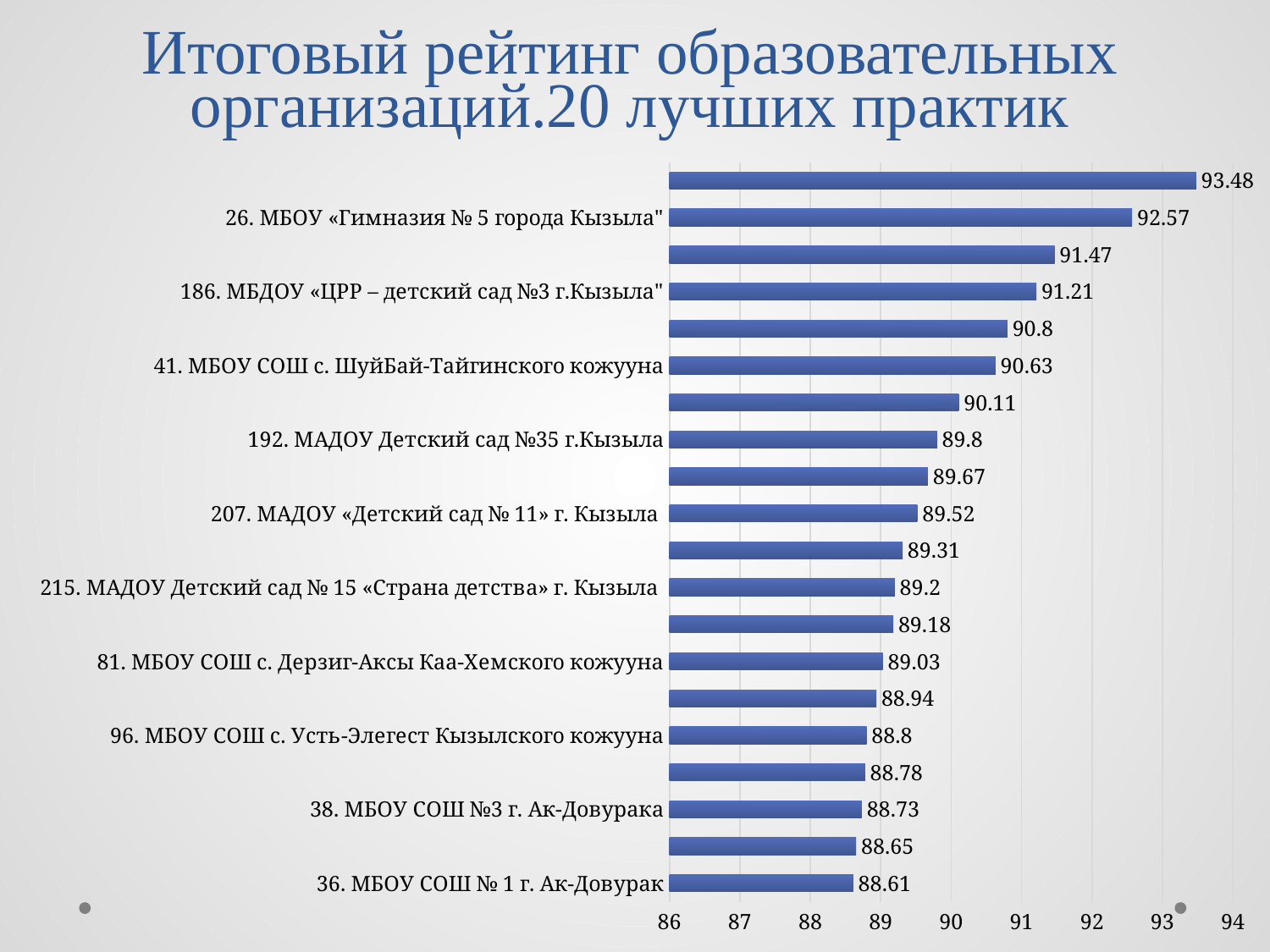
What is the value for 41. МБОУ СОШ с. ШуйБай-Тайгинского кожууна? 90.63 What is the value for 186. МБДОУ «ЦРР – детский сад №3 г.Кызыла"? 91.21 What is the difference between the values for 26. МБОУ «Гимназия № 5 города Кызыла" and 186. МБДОУ «ЦРР – детский сад №3 г.Кызыла"? 1.36 What is the value for 26. МБОУ «Гимназия № 5 города Кызыла"? 92.57 How many bars are plotted in the chart? 20 What is the value for 36. МБОУ СОШ № 1 г. Ак-Довурак? 88.61 Which labelled organisation has the lowest value in the chart? 36. МБОУ СОШ № 1 г. Ак-Довурак What is the title of the slide? Итоговый рейтинг образовательных организаций.20 лучших практик What kind of chart is shown on the slide? Bar chart Which has a larger value: 192. МАДОУ Детский сад №35 г.Кызыла or 207. МАДОУ «Детский сад № 11» г. Кызыла? 192. МАДОУ Детский сад №35 г.Кызыла Is the value for 26. МБОУ «Гимназия № 5 города Кызыла" greater or less than 92? greater What is the highest value shown in the chart? 93.48